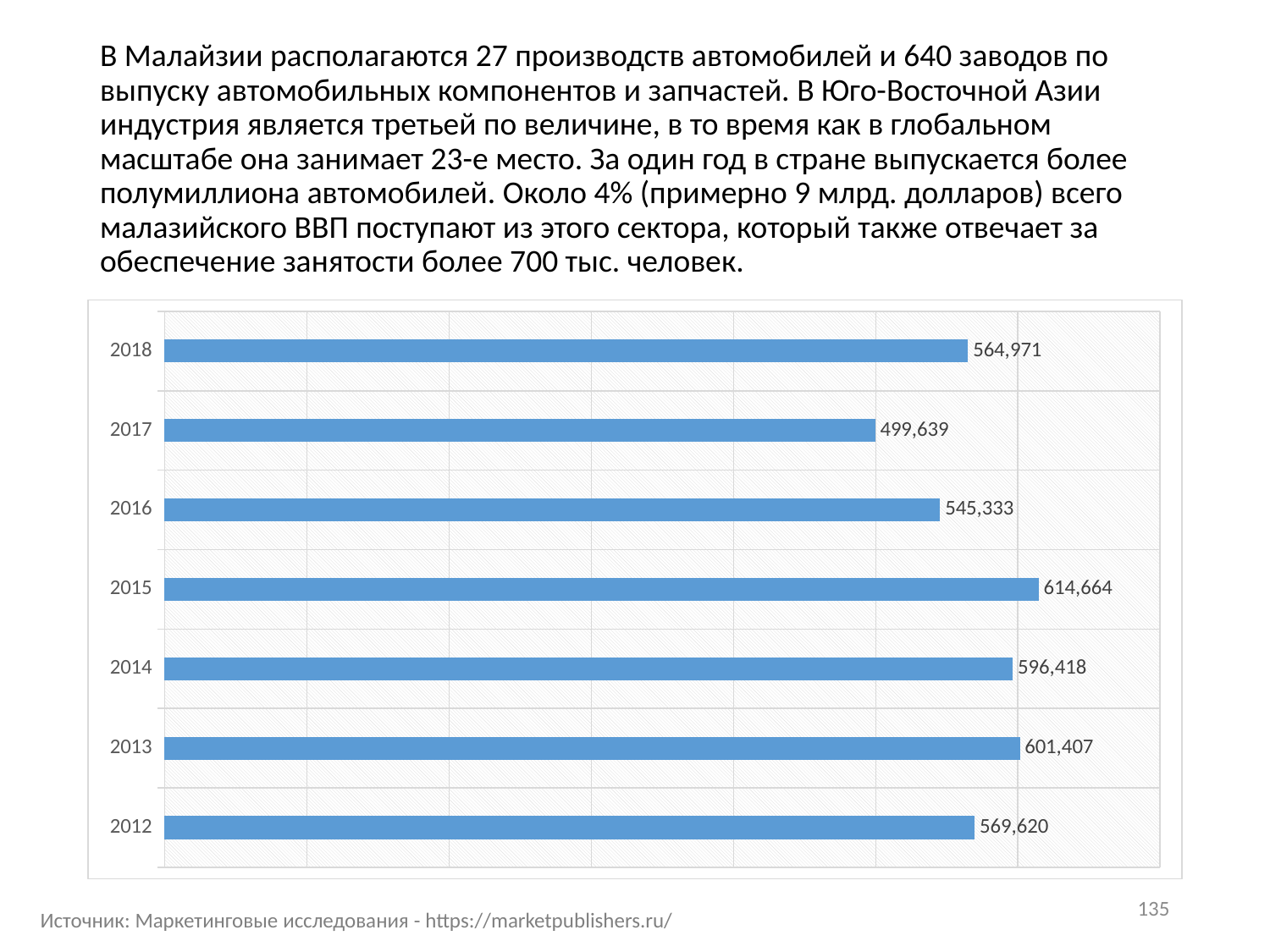
Which year has the lowest value? 2017 What is the value shown for 2016? 545,333 Which is larger, the value for 2013 or the value for 2014? 2013 What kind of chart is shown on the slide? Bar chart What is the difference between the values for 2015 and 2017? 115,025 What is the value shown for 2012? 569,620 What is the value shown for 2018? 564,971 What is the difference between the values for 2018 and 2017? 65,332 What is the value shown for 2015? 614,664 Which year has the highest value? 2015 How many years are shown in the chart? 7 Which is larger, the value for 2016 or the value for 2017? 2016